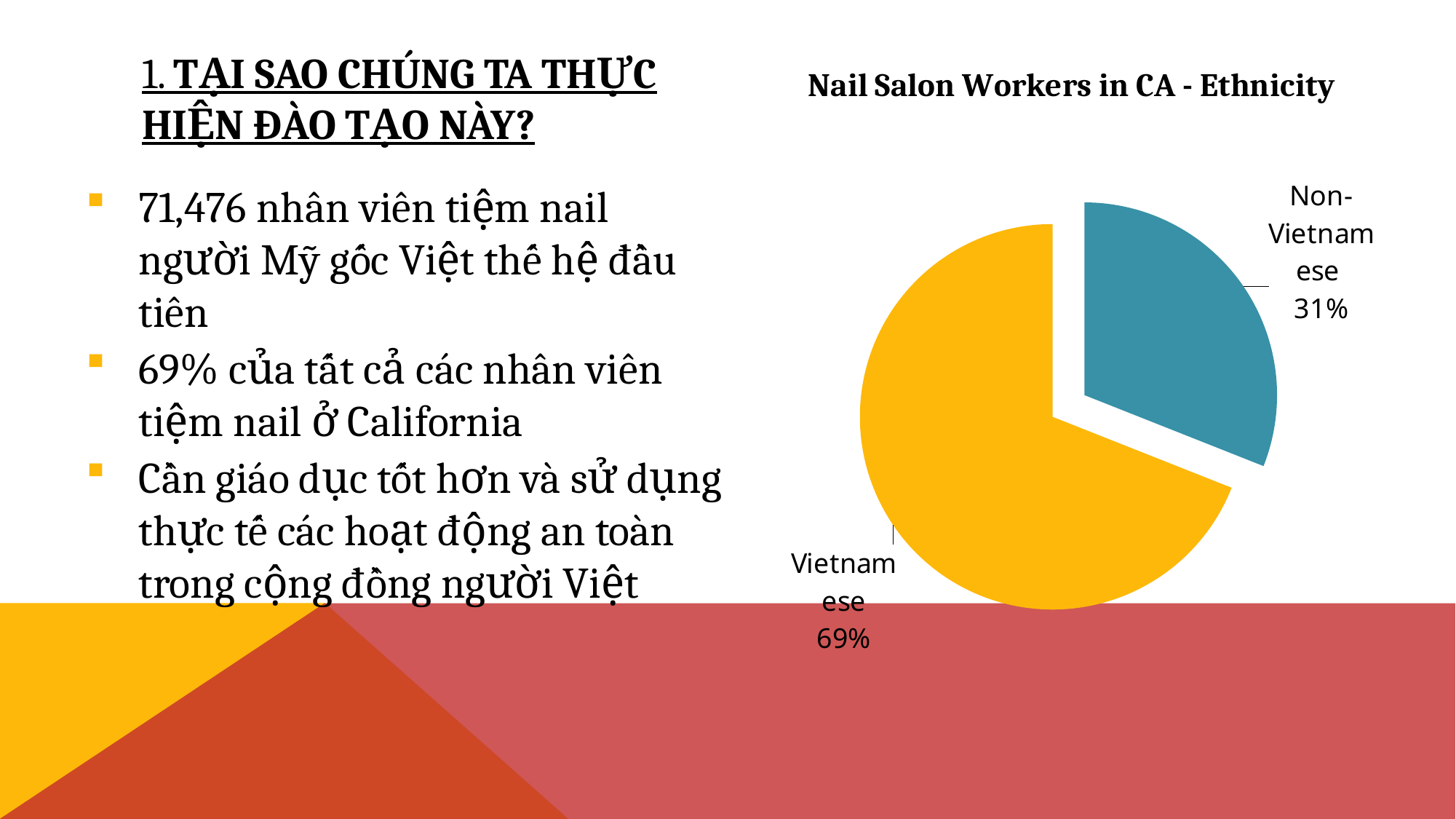
What is the title of the chart? Nail Salon Workers in CA - Ethnicity What share of the pie is labelled Vietnamese? 69% Which slice of the pie is the smallest? Non-Vietnamese What colour is the Non-Vietnamese slice? teal How many slices does the pie chart have? 2 Which is larger, the Vietnamese slice or the Non-Vietnamese slice? Vietnamese What is the difference in percentage points between the Vietnamese and Non-Vietnamese slices? 38 Which slice of the pie is the largest? Vietnamese What kind of chart is shown on the slide? pie chart What share of the pie is labelled Non-Vietnamese? 31% Is the Vietnamese share greater or less than 50%? greater